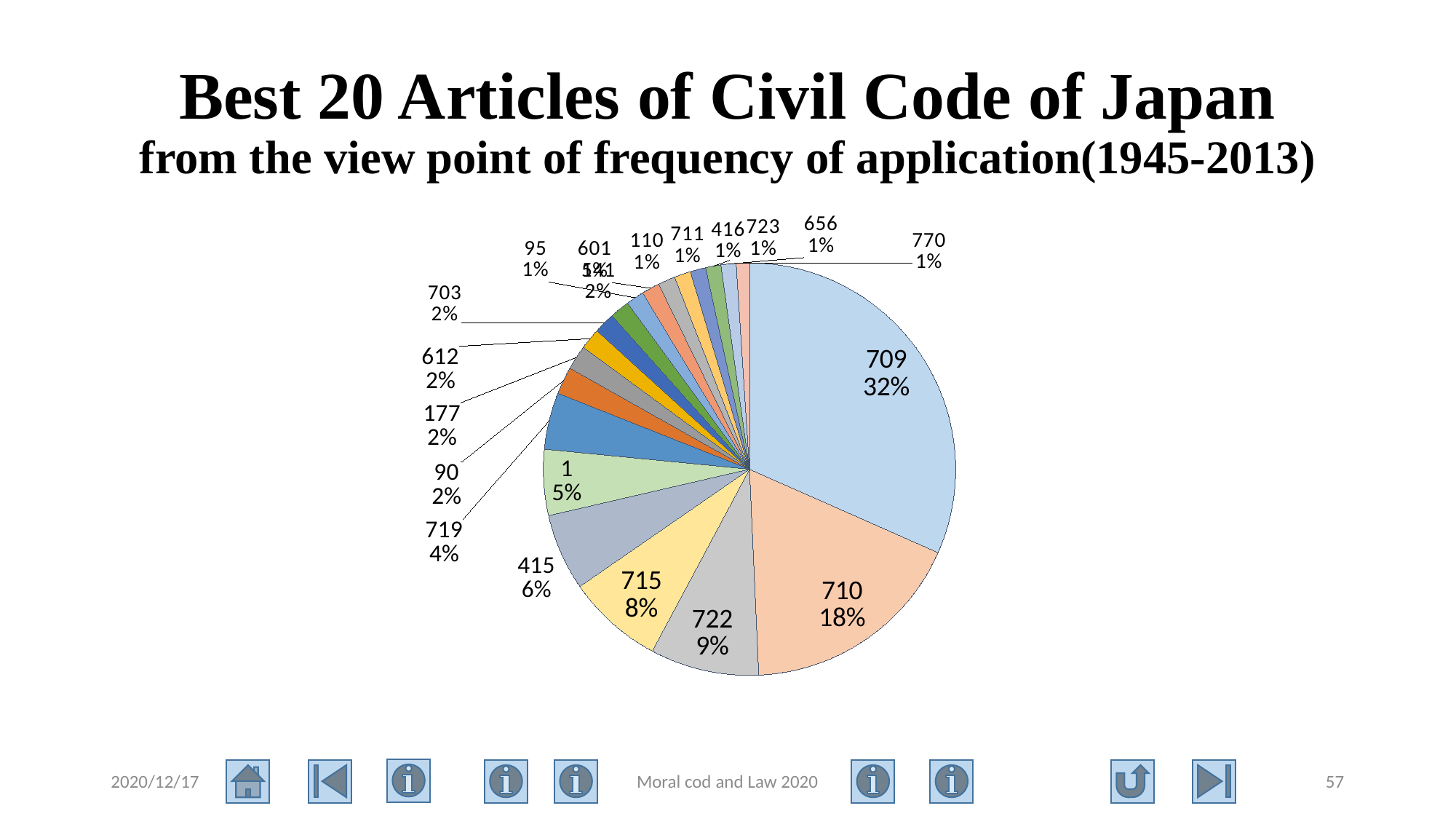
What kind of chart is shown on the slide? pie chart Which article has the largest slice of the pie? 709 What percentage is shown for Article 715? 8% Which has the larger share, Article 722 or Article 715? 722 What percentage is shown for Article 1? 5% What percentage is shown for Article 415? 6% What percentage is shown for Article 722? 9% What share of the pie does Article 709 account for? 32% What is the main title of the chart on the slide? Best 20 Articles of Civil Code of Japan What percentage is shown for Article 710? 18% How many percentage points larger is the share of Article 709 than that of Article 710? 14 percentage points What percentage is shown for Article 719? 4%